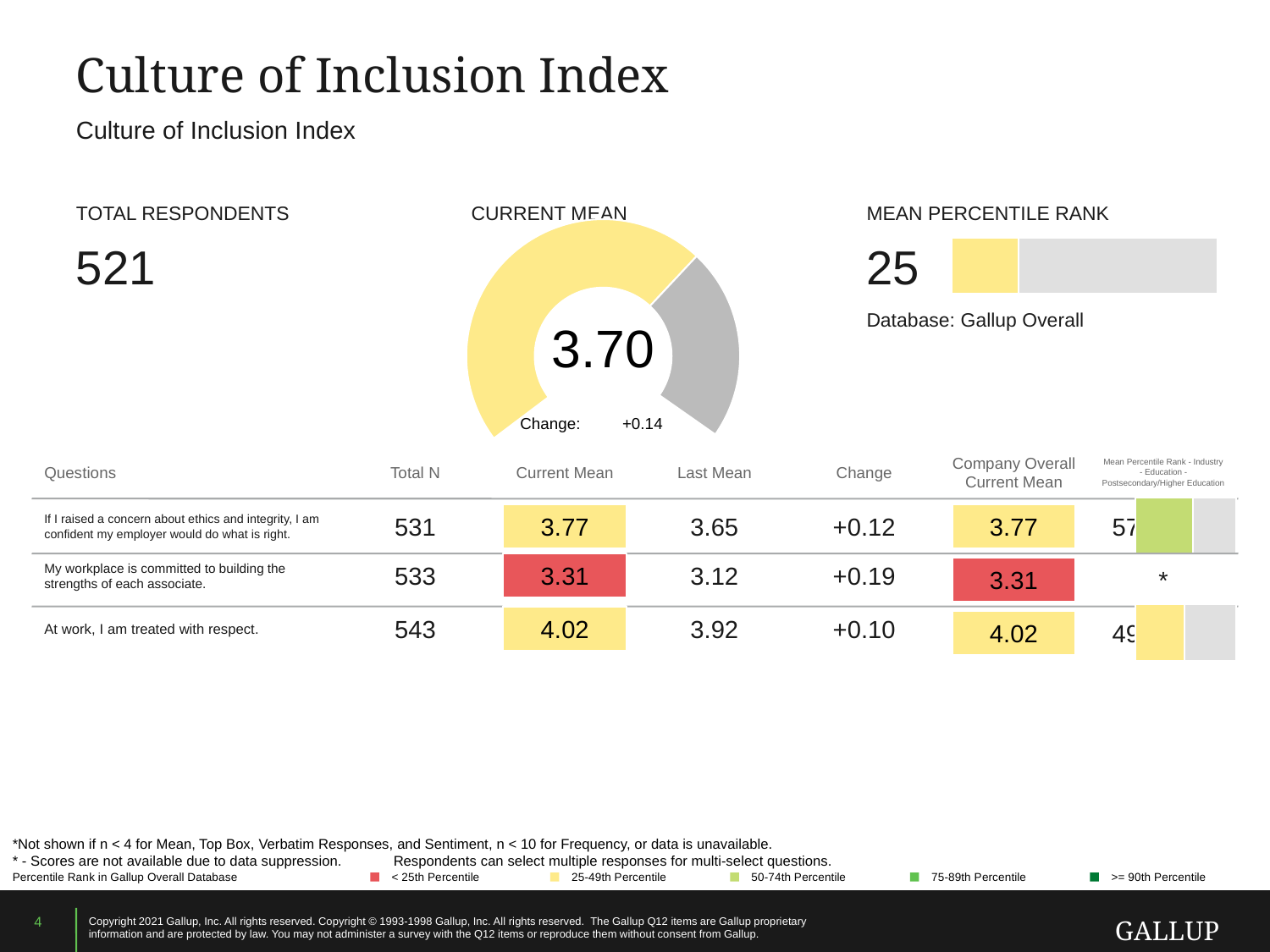
Which database is the Mean Percentile Rank based on? Gallup Overall In the table, which question has the lowest Current Mean? My workplace is committed to building the strengths of each associate. What kind of chart is used to display the Current Mean of 3.70? Gauge chart How many questions are listed in the table? 3 What change value is shown below the Current Mean gauge chart? +0.14 In the table, which question has the highest Current Mean? At work, I am treated with respect. In the table, what is the Last Mean for the question 'My workplace is committed to building the strengths of each associate.'? 3.12 What is the current mean shown on the Current Mean gauge chart? 3.70 In the table, what is the Current Mean for the question 'At work, I am treated with respect.'? 4.02 In the table, what is the difference between the Current Mean and Last Mean for 'If I raised a concern about ethics and integrity, I am confident my employer would do what is right.'? +0.12 What is the total number of respondents shown on the slide? 521 What is the Mean Percentile Rank shown on the slide? 25